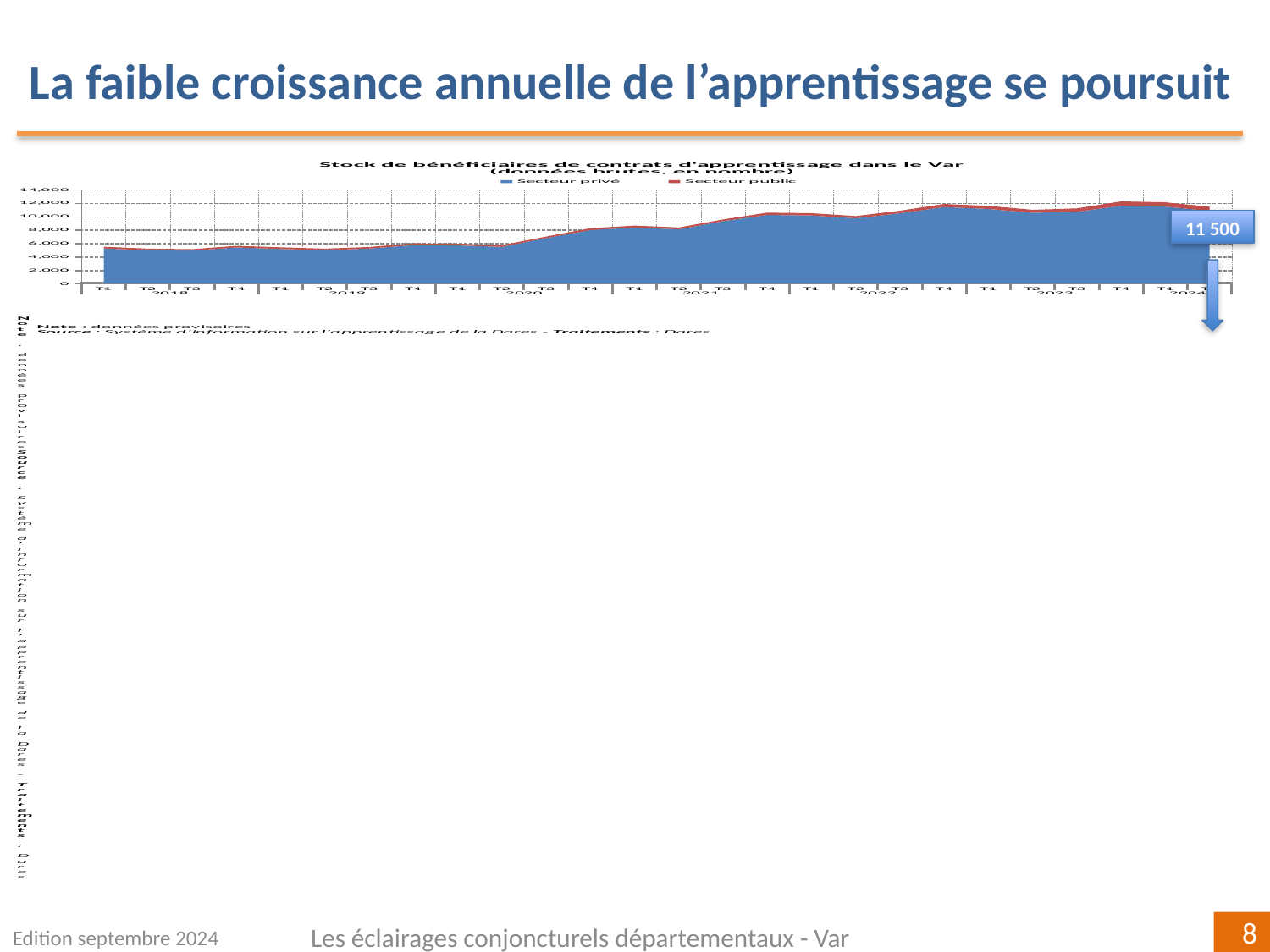
Is the total value for T3 2021 greater or less than 8,000? greater Which is larger, the total value for T4 2023 or for T1 2018? T4 2023 What is the title of the chart? Stock de bénéficiaires de contrats d'apprentissage dans le Var (données brutes, en nombre) How many years are labelled on the x axis of the chart? 7 How many series does the chart legend list? 2 What kind of chart is shown on the slide? Area chart Overall, does the stock of apprenticeship beneficiaries rise or fall from 2018 to 2024? Rise Is the total value for T1 2018 greater or less than 6,000? less Is the total value for T4 2022 greater or less than 10,000? greater What value does the callout give for the most recent point of the series? 11 500 Which two series are listed in the chart legend? Secteur privé and Secteur public